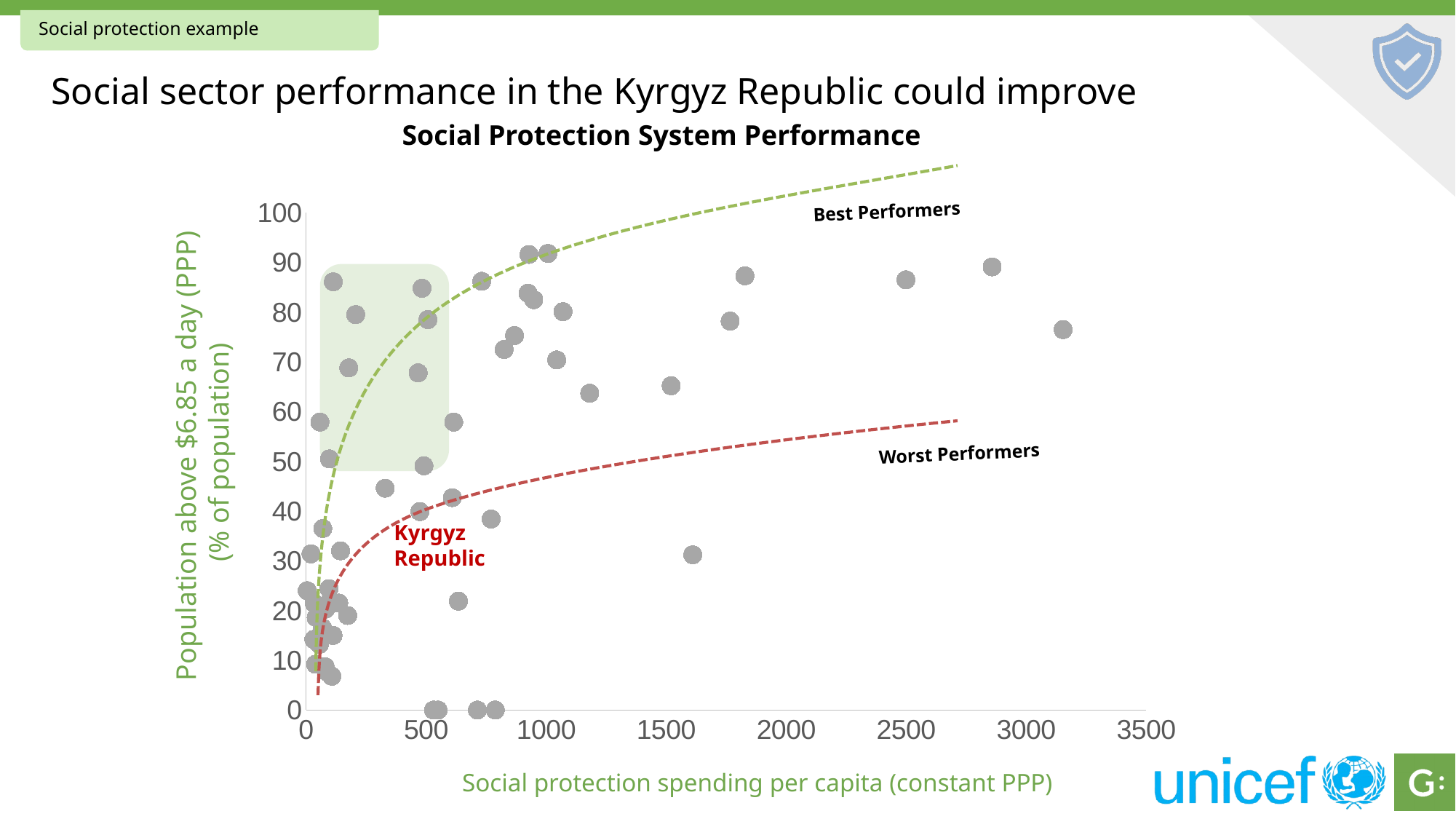
What is the title of the chart? Social Protection System Performance What is the highest tick value shown on the y axis? 100 What is the lowest tick value shown on the y axis? 0 What is the interval between consecutive ticks on the x axis? 500 What is the highest tick value shown on the x axis? 3500 Which country is labelled by name on the chart? Kyrgyz Republic Do the Best Performers and Worst Performers dashed lines rise or fall as spending per capita increases? Rise What is the label of the x axis of the chart? Social protection spending per capita (constant PPP) What kind of chart is shown on the slide? Scatter chart Which dashed line lies higher on the chart, Best Performers or Worst Performers? Best Performers